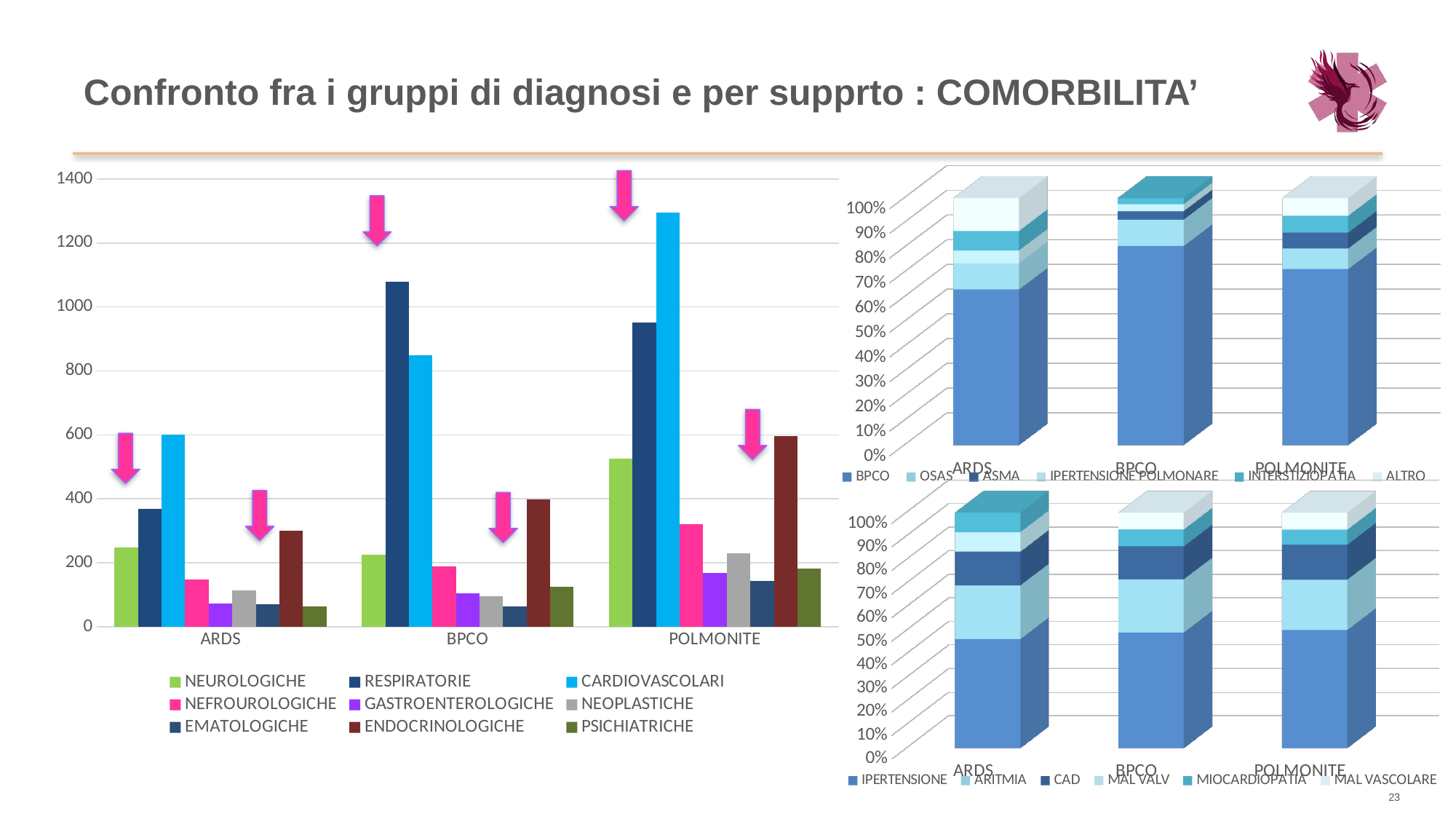
In the left chart, for BPCO, which is larger: RESPIRATORIE or CARDIOVASCOLARI? RESPIRATORIE How many series does the legend of the left chart list? 9 In the left chart, is the CARDIOVASCOLARI value for POLMONITE greater or less than 1200? greater In the left chart, which category has the highest ENDOCRINOLOGICHE value? POLMONITE How many series does the legend of the top-right stacked chart list? 6 How many categories are shown on the x axis of the left chart? 3 How many categories are shown on the x axis of the bottom-right stacked chart? 3 In the left chart, is the RESPIRATORIE value for BPCO greater or less than 1000? greater In the left chart, which category has the highest CARDIOVASCOLARI value? POLMONITE In the left chart, is the ENDOCRINOLOGICHE value for ARDS greater or less than 200? greater In the left chart, for ARDS, which is larger: RESPIRATORIE or CARDIOVASCOLARI? CARDIOVASCOLARI What kind of chart is the large chart on the left of the slide? bar chart